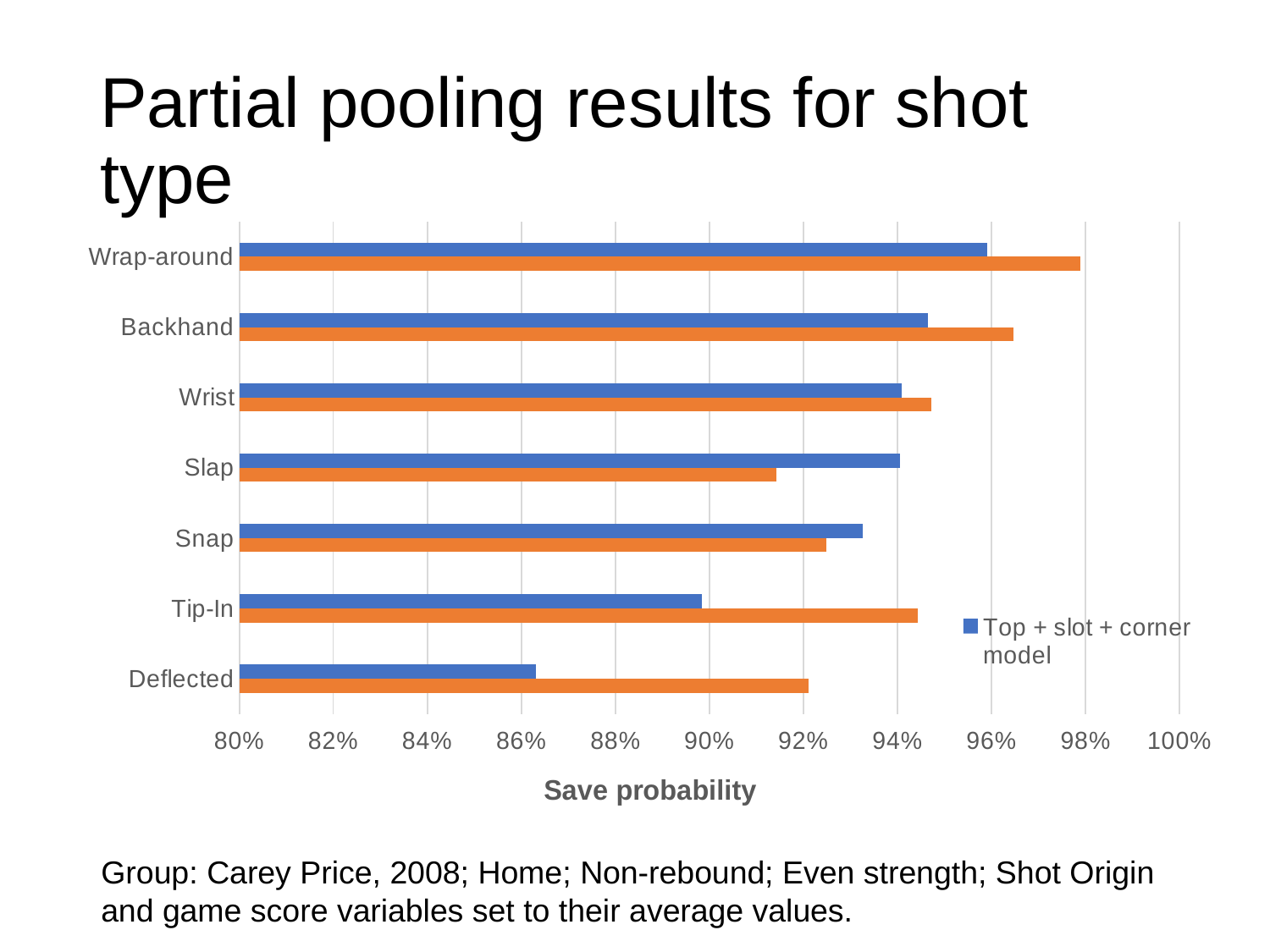
What kind of chart is shown on the slide? bar chart What is the title of the horizontal axis? Save probability Which shot type has the highest save probability for the blue 'Top + slot + corner model' series? Wrap-around Which shot type has the highest value among the orange bars? Wrap-around Which shot type has the lowest save probability for the blue 'Top + slot + corner model' series? Deflected Is the blue bar value for Deflected greater or less than 88%? less For Tip-In shots, which bar is larger, the blue or the orange? orange Is the orange bar value for Wrap-around greater or less than 96%? greater What series name does the legend list for the blue bars? Top + slot + corner model For Slap shots, which bar is larger, the blue or the orange? blue How many shot type categories are plotted on the chart? 7 Is the orange bar value for Slap greater or less than 92%? less